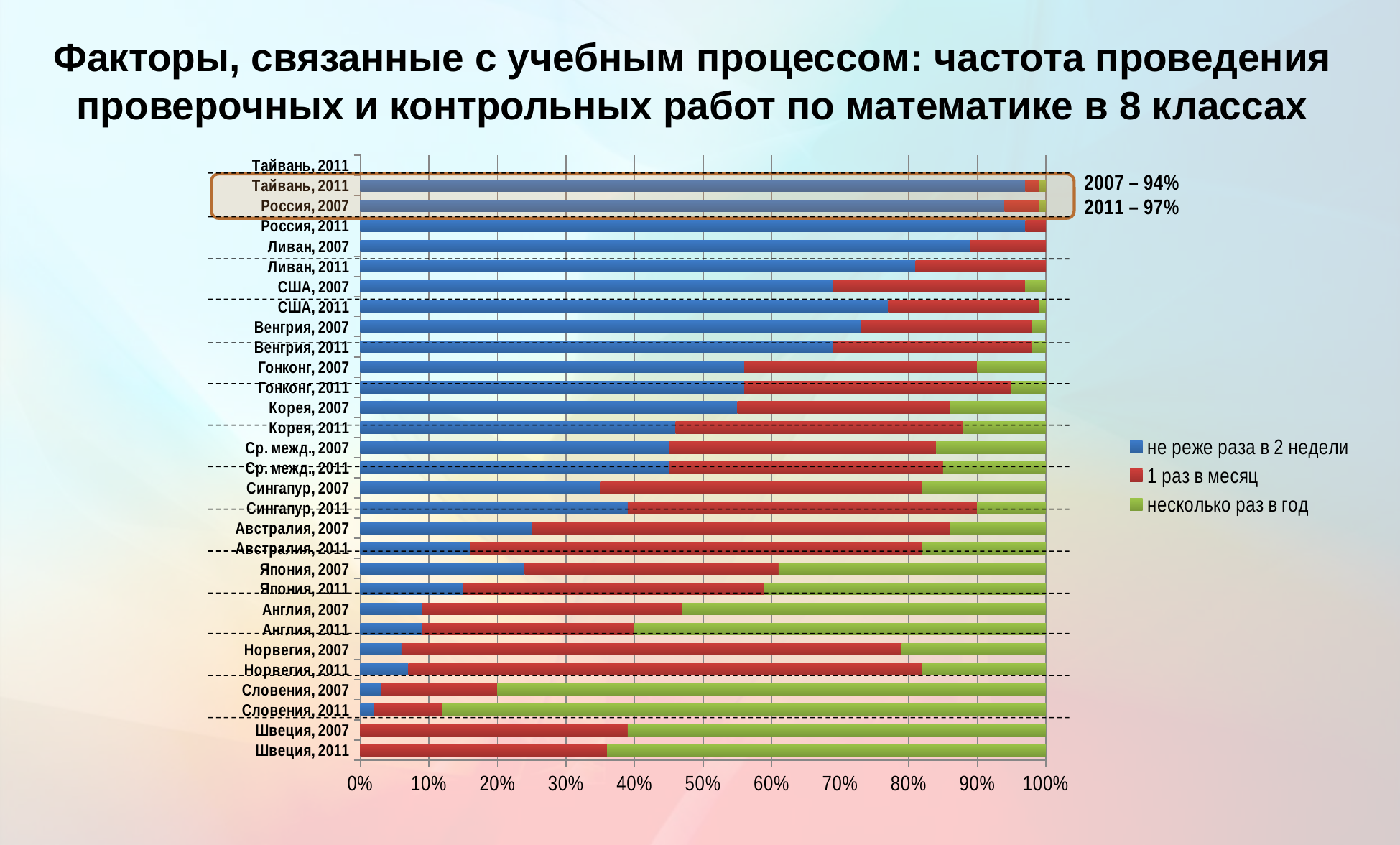
Is the red segment (1 раз в месяц) for Швеция, 2011 greater or less than 40%? less Which has the larger blue segment (не реже раза в 2 недели): Япония, 2007 or Япония, 2011? Япония, 2007 Which series is shown in green according to the legend? несколько раз в год Is the blue segment (не реже раза в 2 недели) for Япония, 2007 greater or less than 20%? greater What kind of chart is shown on the slide? stacked bar chart According to the annotation next to the highlighted bars, what is the value for 2011? 97% Is the blue segment (не реже раза в 2 недели) for Гонконг, 2007 greater or less than 50%? greater Which series is shown in blue according to the legend? не реже раза в 2 недели According to the annotation next to the highlighted bars, what is the value for 2007? 94% Moving from the top of the chart to the bottom, does the blue segment (не реже раза в 2 недели) generally get longer or shorter? shorter How many series does the legend list? 3